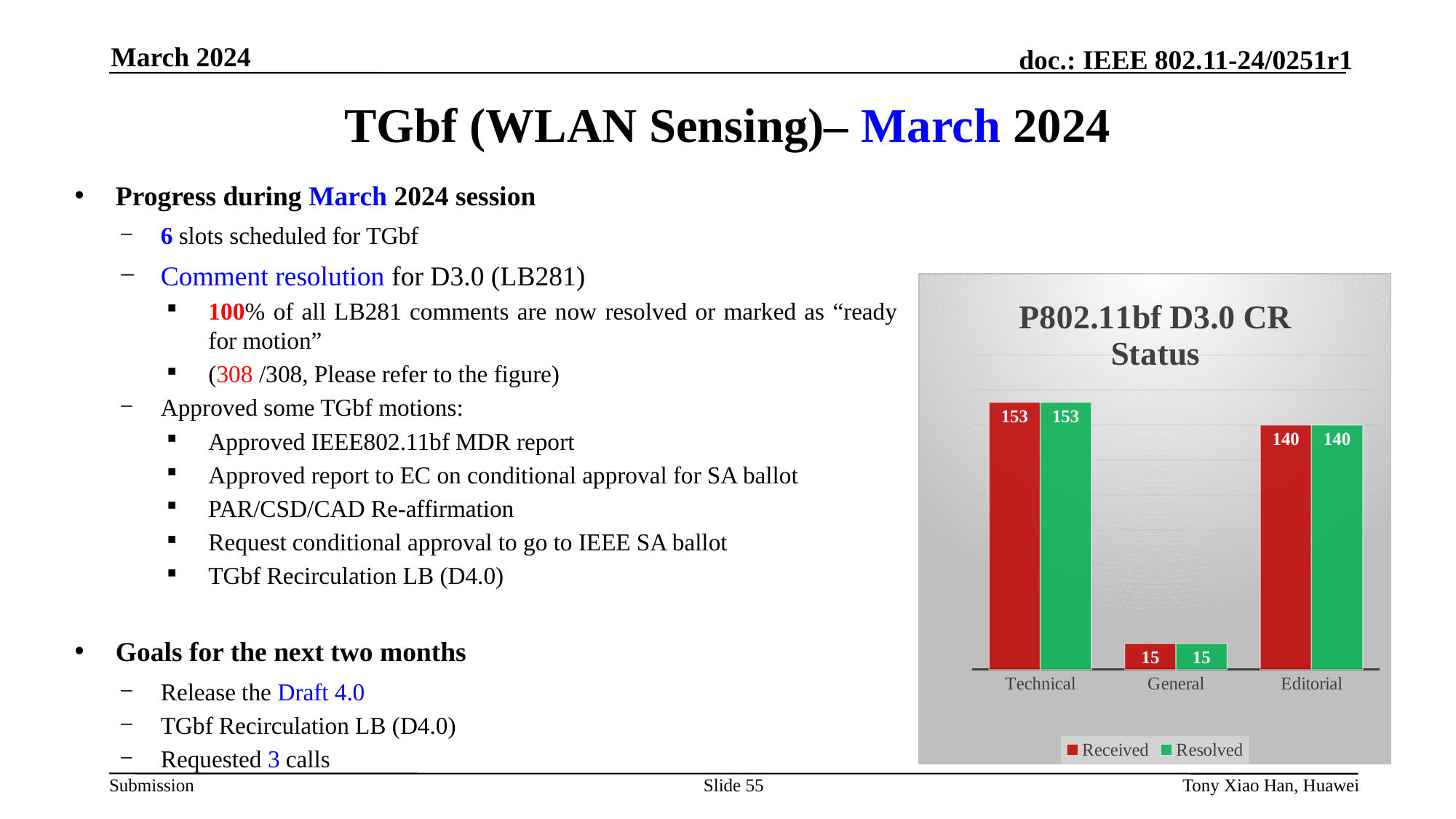
Which category has the lowest Resolved value? General How many categories are shown on the x axis? 3 What is the difference between the Resolved values for Editorial and General? 125 What is the Received value for Editorial? 140 How many series does the legend list? 2 Which category has the highest Received value? Technical What kind of chart is shown? bar chart What is the title of the chart? P802.11bf D3.0 CR Status What is the Received value for Technical? 153 Which is larger, the Received value for Technical or the Received value for Editorial? Technical What is the difference between the Received values for Technical and Editorial? 13 What is the Resolved value for General? 15